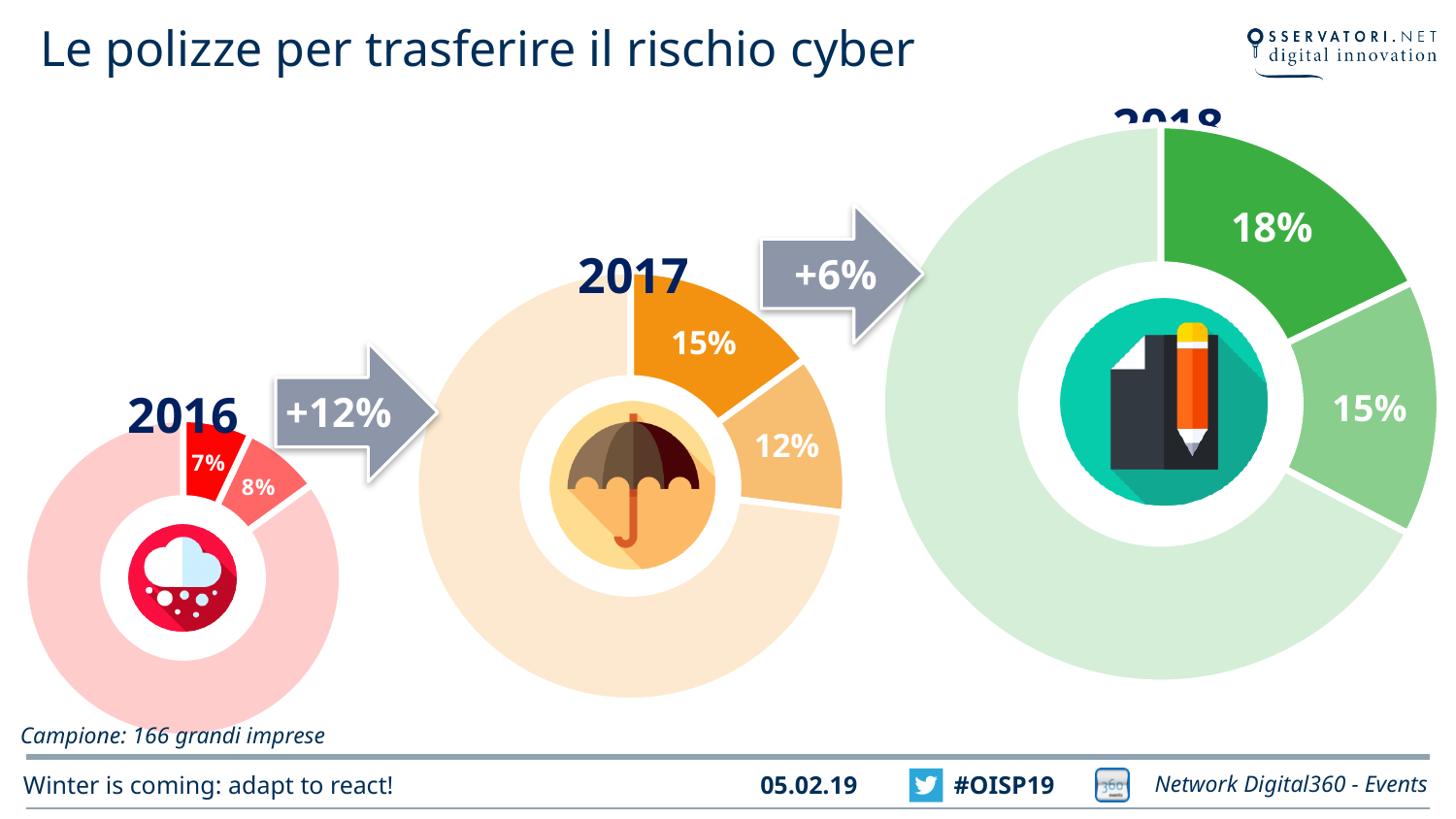
What is the combined share of the two labelled slices in the 2018 chart? 33% What increase is shown on the arrow between the 2016 and 2017 charts? +12% In the 2017 chart, what is the value of the dark orange slice? 15% In the 2018 chart, what is the value of the dark green slice? 18% Which year's chart has the largest single labelled slice? 2018 In the 2017 chart, what is the value of the light orange slice? 12% How many donut charts are shown on the slide? 3 What is the combined share of the two labelled slices in the 2017 chart? 27% In the 2016 chart, what is the value of the darker red slice? 7% In the 2018 chart, what is the value of the light green slice? 15% What kind of chart is used to show the data for each year on this slide? Donut (pie) chart In the 2016 chart, what is the value of the lighter red slice? 8%